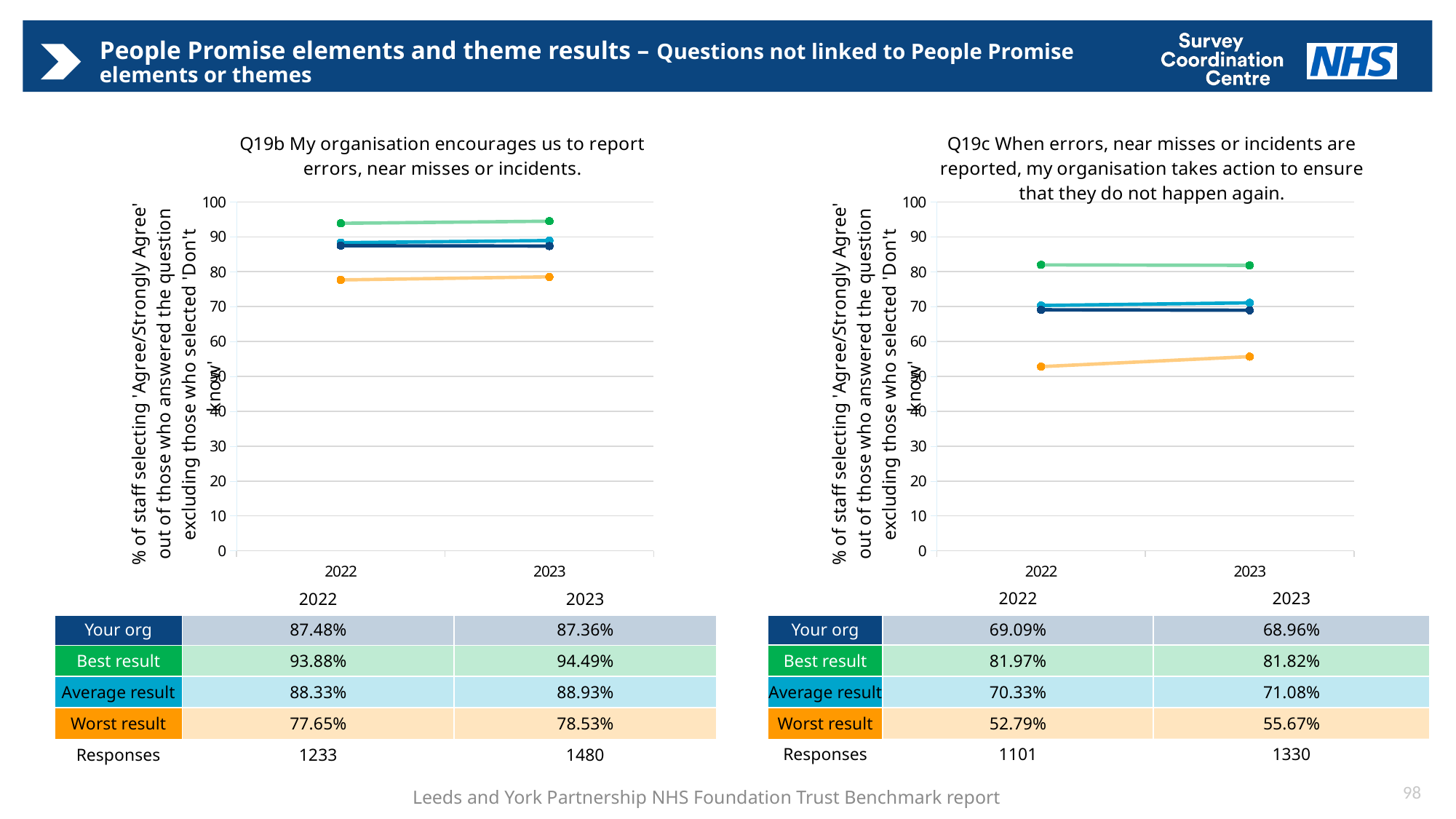
In the Q19c chart, what is the 'Average result' value for 2023? 71.08% In the Q19c chart, what is the 'Worst result' value for 2022? 52.79% How many years are plotted on the x axis of the Q19c chart? 2 In the Q19b chart, is the 'Your org' value for 2022 larger or smaller than the 'Average result' value for 2022? smaller In the Q19c chart, what is the difference between the 'Best result' and 'Worst result' values in 2023? 26.15% In the Q19b chart, which series has the lowest value in 2023? Worst result How many responses are listed for 2023 under the Q19b chart? 1480 In the Q19b chart, what is the 'Your org' value for 2023? 87.36% In the Q19b chart, what is the 'Best result' value for 2022? 93.88% In the Q19c chart, does the 'Worst result' series rise or fall from 2022 to 2023? rise What kind of chart is the Q19b chart? line chart In the Q19c chart, which series has the highest value in 2022? Best result